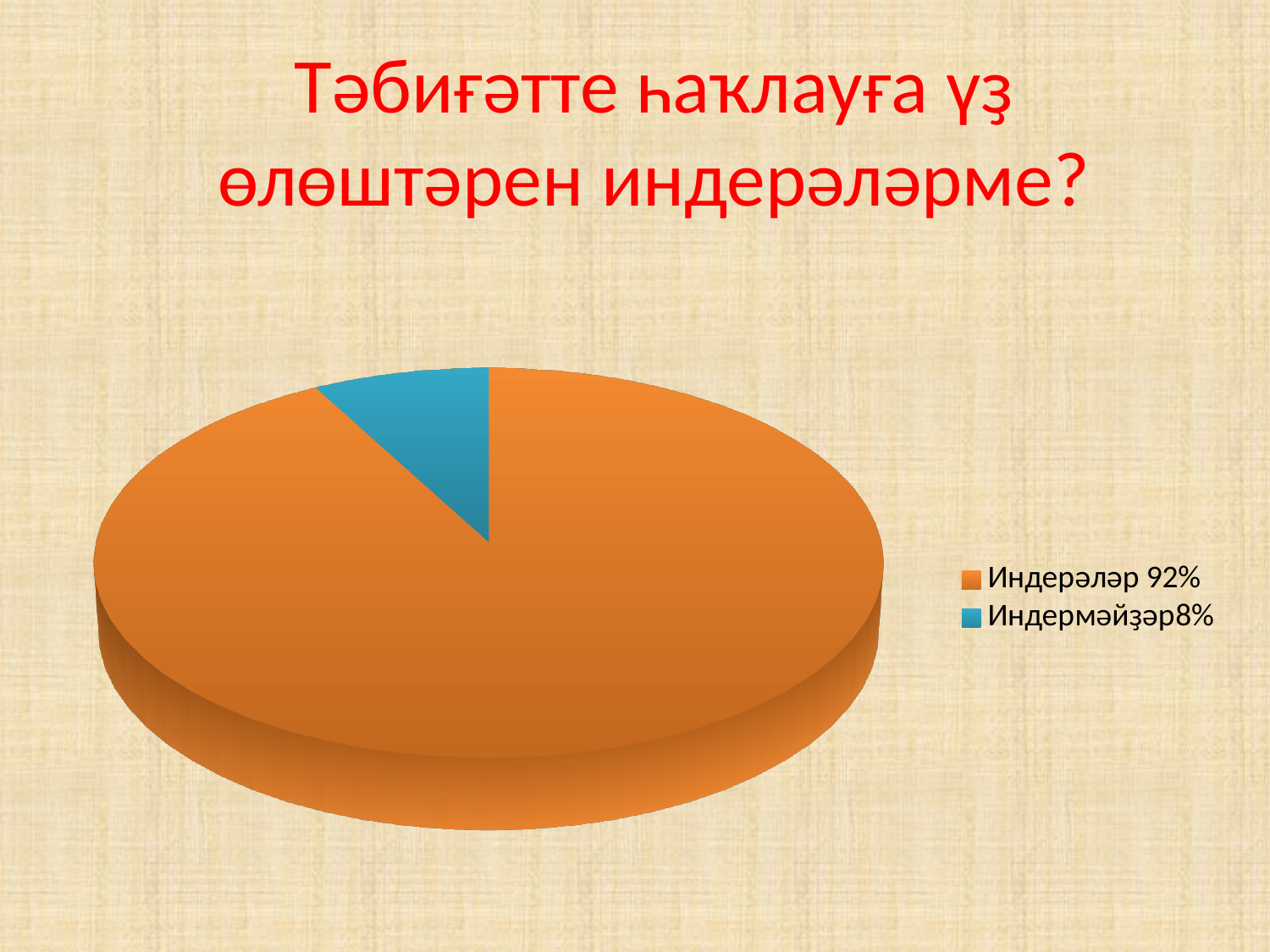
What percentage is shown for Индермәйҙәр in the legend? 8% What kind of chart is shown on the slide? pie chart What colour is the Индермәйҙәр slice? blue How many slices does the pie chart have? 2 What percentage is shown for Индерәләр in the legend? 92% What share of the pie does the Индермәйҙәр slice represent? 8% What is the difference in percentage points between Индерәләр and Индермәйҙәр? 84 Which is larger, the share for Индерәләр or the share for Индермәйҙәр? Индерәләр Which slice of the pie is the largest? Индерәләр Which slice of the pie is the smallest? Индермәйҙәр What colour is the Индерәләр slice? orange How many entries does the legend list? 2